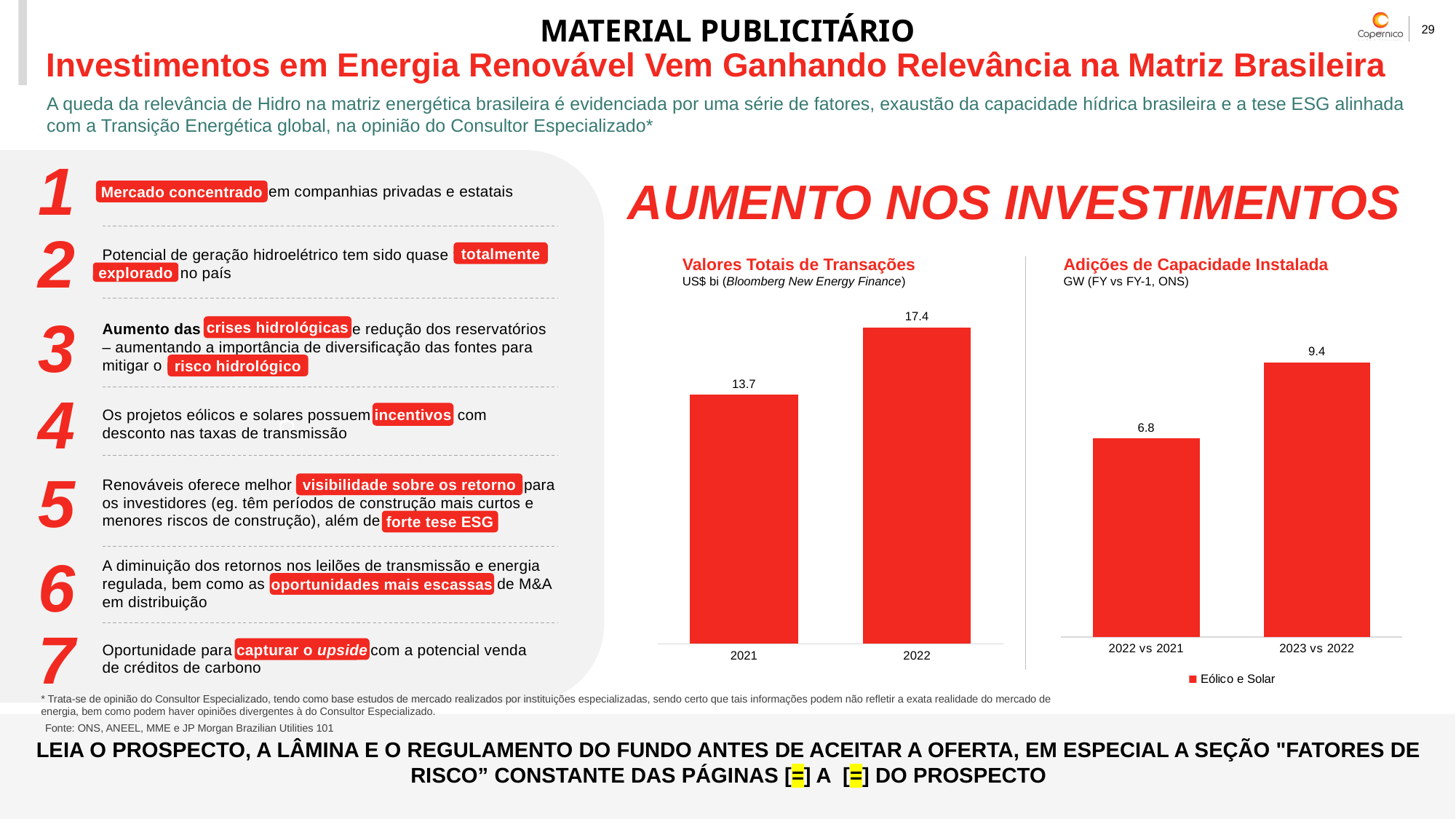
In the 'Valores Totais de Transações' chart, which year has the higher value? 2022 In the 'Valores Totais de Transações' chart, what is the difference between the 2022 and 2021 values? 3.7 In the 'Adições de Capacidade Instalada' chart, what is the difference between the 2023 vs 2022 and 2022 vs 2021 values? 2.6 In the 'Adições de Capacidade Instalada' chart, what is the value for 2023 vs 2022? 9.4 In the 'Valores Totais de Transações' chart, how many bars are plotted? 2 In the 'Adições de Capacidade Instalada' chart, what series name does the legend show? Eólico e Solar In the 'Valores Totais de Transações' chart, what is the value for 2021? 13.7 In the 'Adições de Capacidade Instalada' chart, what is the value for 2022 vs 2021? 6.8 In the 'Valores Totais de Transações' chart, what is the value for 2022? 17.4 What type of chart is the 'Valores Totais de Transações' chart? bar chart In the 'Adições de Capacidade Instalada' chart, which category has the lower value? 2022 vs 2021 In the 'Adições de Capacidade Instalada' chart, do the values rise or fall from left to right? rise